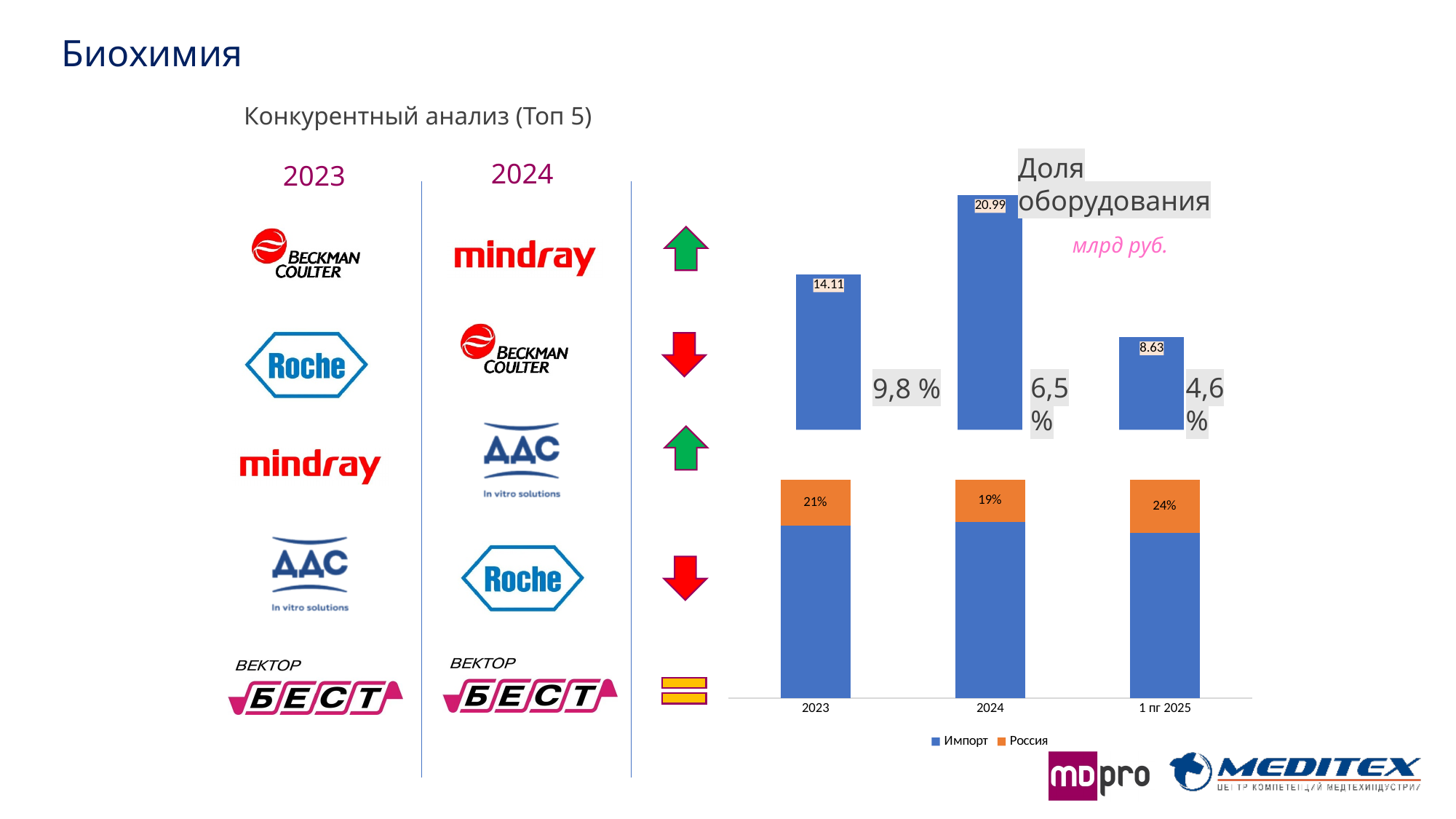
In the bottom stacked bar chart, what is the Россия share for 1 пг 2025? 24% In the top chart titled 'Доля оборудования', which bar is the lowest? The rightmost bar (8.63) In the top chart titled 'Доля оборудования', how many bars are plotted? 3 In the top chart titled 'Доля оборудования', what unit is stated for the values? млрд руб. In the top chart titled 'Доля оборудования', what is the value of the rightmost bar? 8.63 In the top chart titled 'Доля оборудования', what is the value of the first (leftmost) bar? 14.11 In the top chart titled 'Доля оборудования', which bar is the highest? The middle bar (20.99) In the bottom stacked bar chart, what is the Россия share for 2023? 21% In the bottom stacked bar chart, which category has the lowest Россия share? 2024 In the top chart titled 'Доля оборудования', what is the value of the middle bar? 20.99 In the top chart titled 'Доля оборудования', what is the difference between the middle bar and the leftmost bar? 6.88 How many series does the legend of the bottom stacked bar chart list? 2